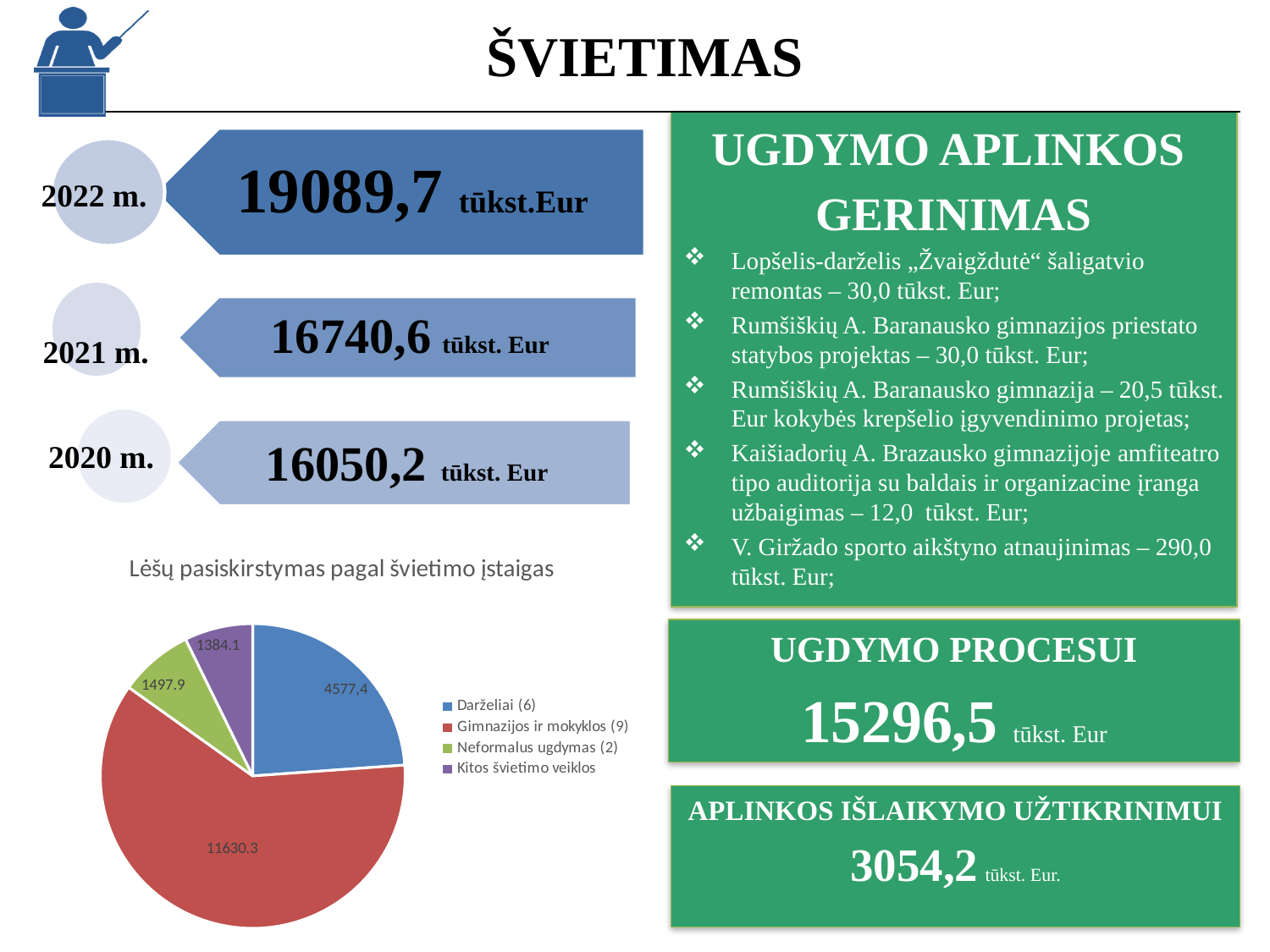
In the pie chart, which is larger: Neformalus ugdymas (2) or Kitos švietimo veiklos? Neformalus ugdymas (2) In the pie chart, what colour is the slice for Gimnazijos ir mokyklos (9)? red In the pie chart, what is the value for Neformalus ugdymas (2)? 1497.9 What is the title of the pie chart? Lėšų pasiskirstymas pagal švietimo įstaigas How many slices does the pie chart have? 4 In the pie chart, what is the value for Kitos švietimo veiklos? 1384.1 What type of chart is "Lėšų pasiskirstymas pagal švietimo įstaigas"? pie chart Which category has the smallest slice in the pie chart? Kitos švietimo veiklos In the pie chart, what is the value for Darželiai (6)? 4577,4 In the pie chart, what is the value for Gimnazijos ir mokyklos (9)? 11630.3 Which category has the largest slice in the pie chart? Gimnazijos ir mokyklos (9) In the pie chart, what is the difference between the values for Gimnazijos ir mokyklos (9) and Darželiai (6)? 7052.9